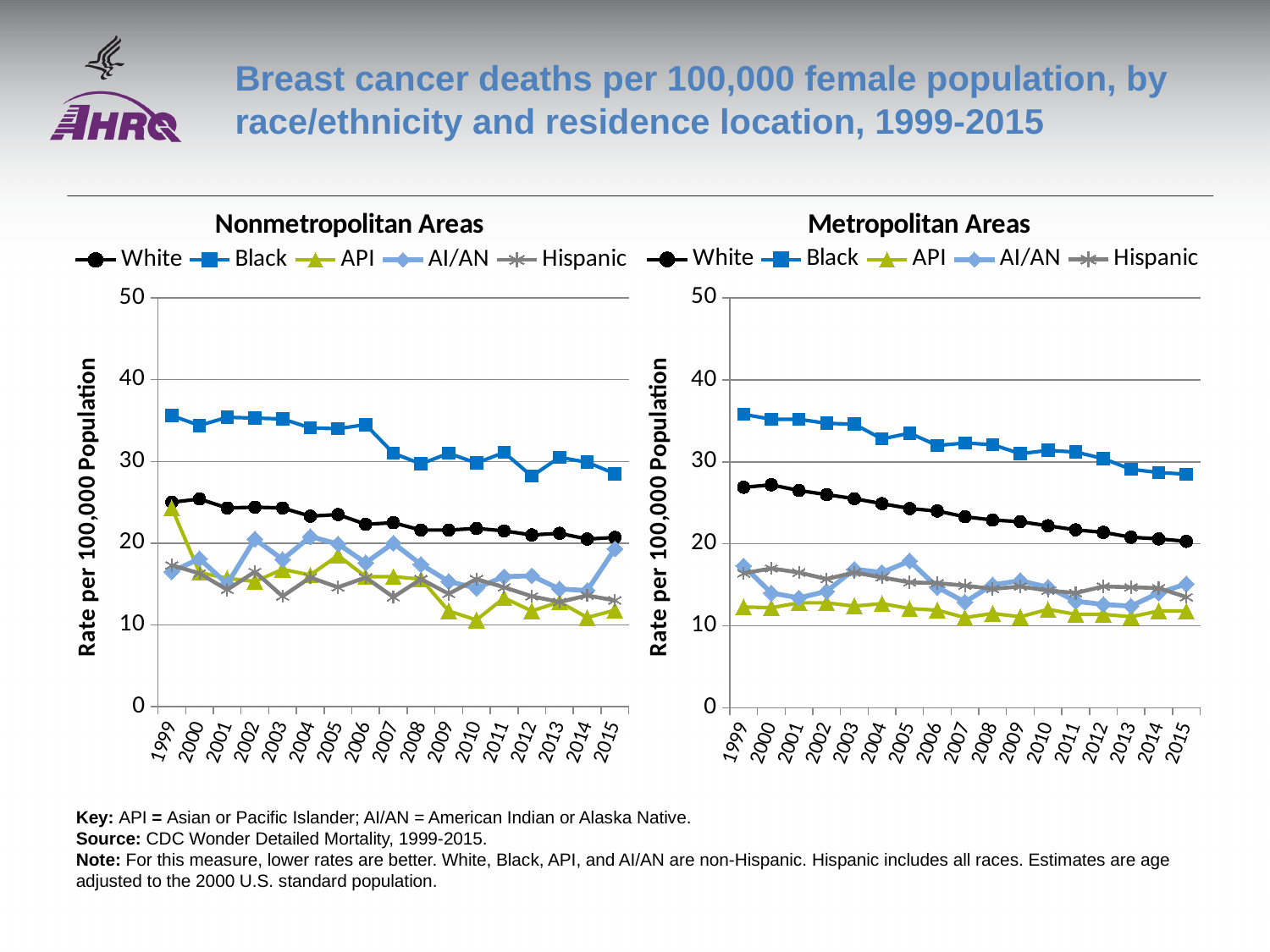
What kind of chart is the Nonmetropolitan Areas chart? line chart In the Metropolitan Areas chart, which series has the lowest value in 2015? API In the Metropolitan Areas chart, is the value for Black in 2015 greater or less than 30? less In the Nonmetropolitan Areas chart, is the value for Black in 1999 greater or less than 30? greater How many years are plotted along the x axis of the Nonmetropolitan Areas chart? 17 In the Nonmetropolitan Areas chart, which series has the highest values across all years? Black In the Nonmetropolitan Areas chart, is the value for Black in 2012 greater or less than 30? less What is the label on the y axis of the Nonmetropolitan Areas chart? Rate per 100,000 Population In the Metropolitan Areas chart, which is larger in 1999, the value for Black or the value for White? Black How many series does the legend of the Metropolitan Areas chart list? 5 In the Metropolitan Areas chart, does the White series rise or fall from 1999 to 2015? fall